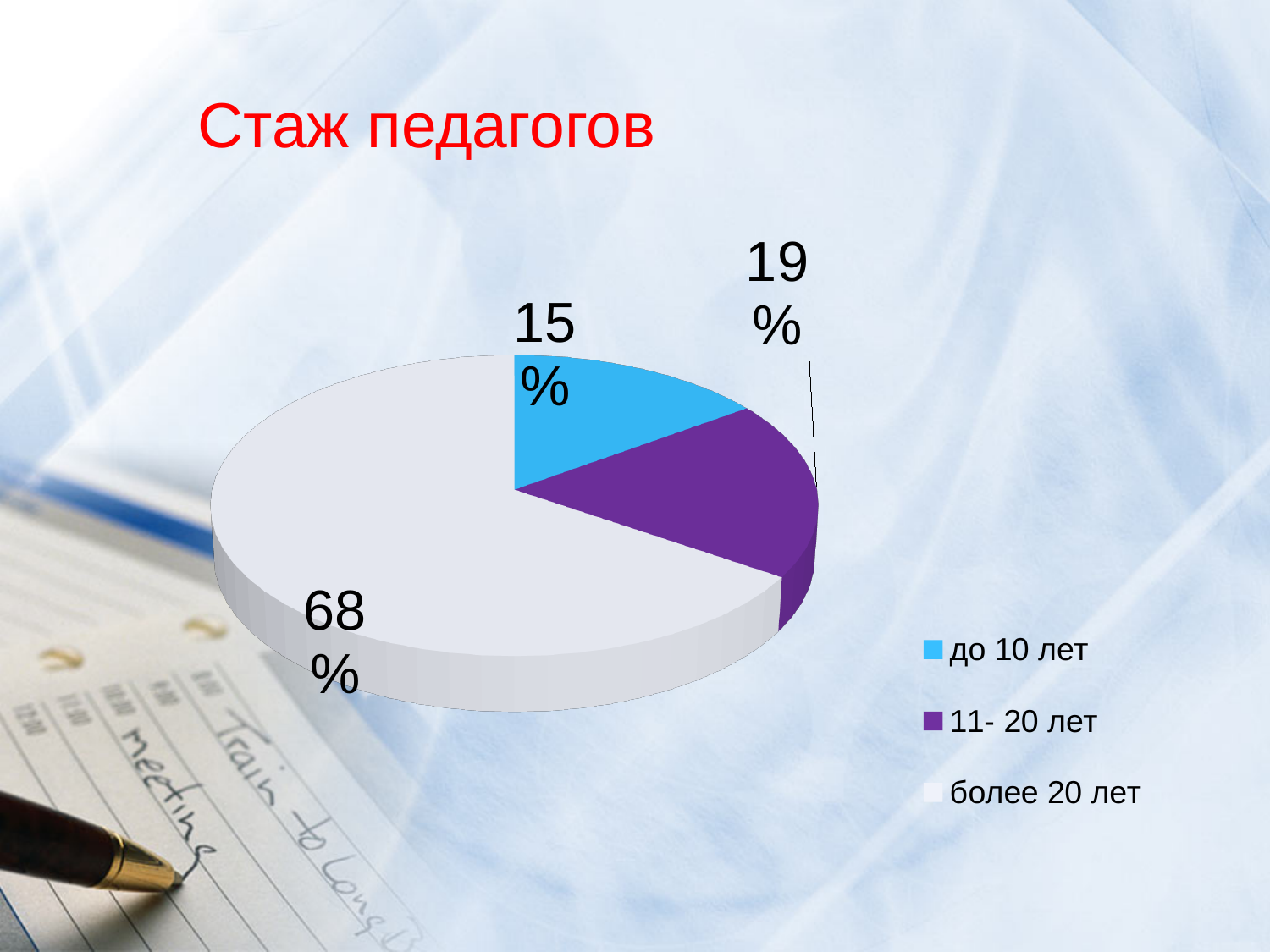
How many categories does the pie chart have? 3 What share of the pie does the 'до 10 лет' slice represent? 15% What is the title of the chart? Стаж педагогов What is the difference in percentage points between the '11- 20 лет' slice and the 'до 10 лет' slice? 4 Which is larger, the 'до 10 лет' slice or the '11- 20 лет' slice? 11- 20 лет What share of the pie does the 'более 20 лет' slice represent? 68% What is the difference in percentage points between the 'более 20 лет' slice and the '11- 20 лет' slice? 49 Which category has the largest slice of the pie? более 20 лет What share of the pie does the '11- 20 лет' slice represent? 19% Which colour represents the 'до 10 лет' category in the legend? light blue Which category has the smallest slice of the pie? до 10 лет What kind of chart is shown on the slide? pie chart